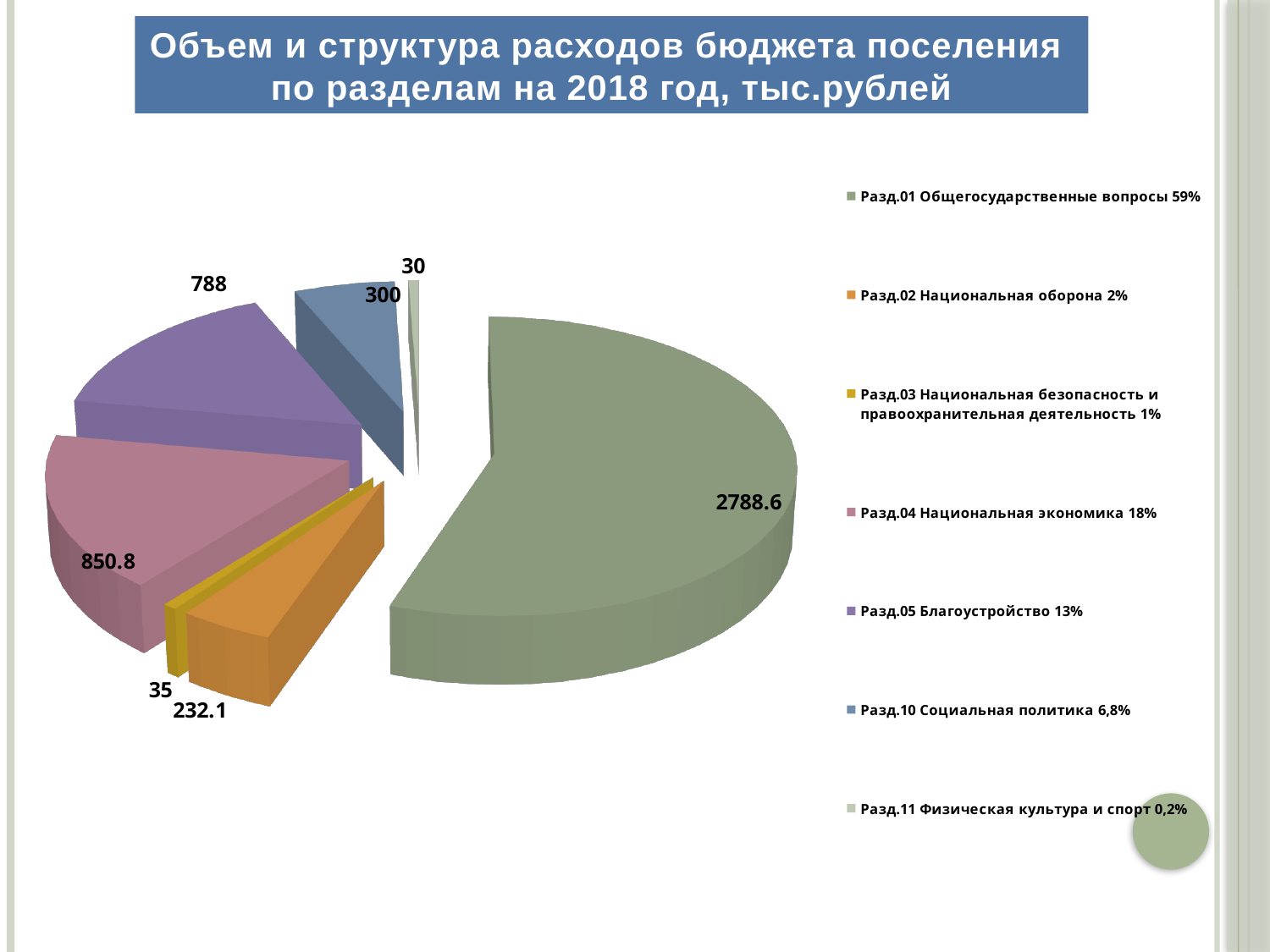
What kind of chart is shown on the slide? pie chart What is the difference between the values for Разд.10 Социальная политика and Разд.11 Физическая культура и спорт? 270 What is the difference between the values for Разд.01 Общегосударственные вопросы and Разд.04 Национальная экономика? 1937.8 What is the value for Разд.05 Благоустройство? 788 Which section has the largest slice of the pie? Разд.01 Общегосударственные вопросы What is the value for Разд.01 Общегосударственные вопросы? 2788.6 What is the value for Разд.04 Национальная экономика? 850.8 How many sections (slices) does the pie chart show? 7 According to the legend, what share of the pie does Разд.05 Благоустройство represent? 13% Which section has the smallest slice of the pie? Разд.11 Физическая культура и спорт Which is larger, the value for Разд.02 Национальная оборона or Разд.03 Национальная безопасность и правоохранительная деятельность? Разд.02 Национальная оборона What is the value for Разд.10 Социальная политика? 300